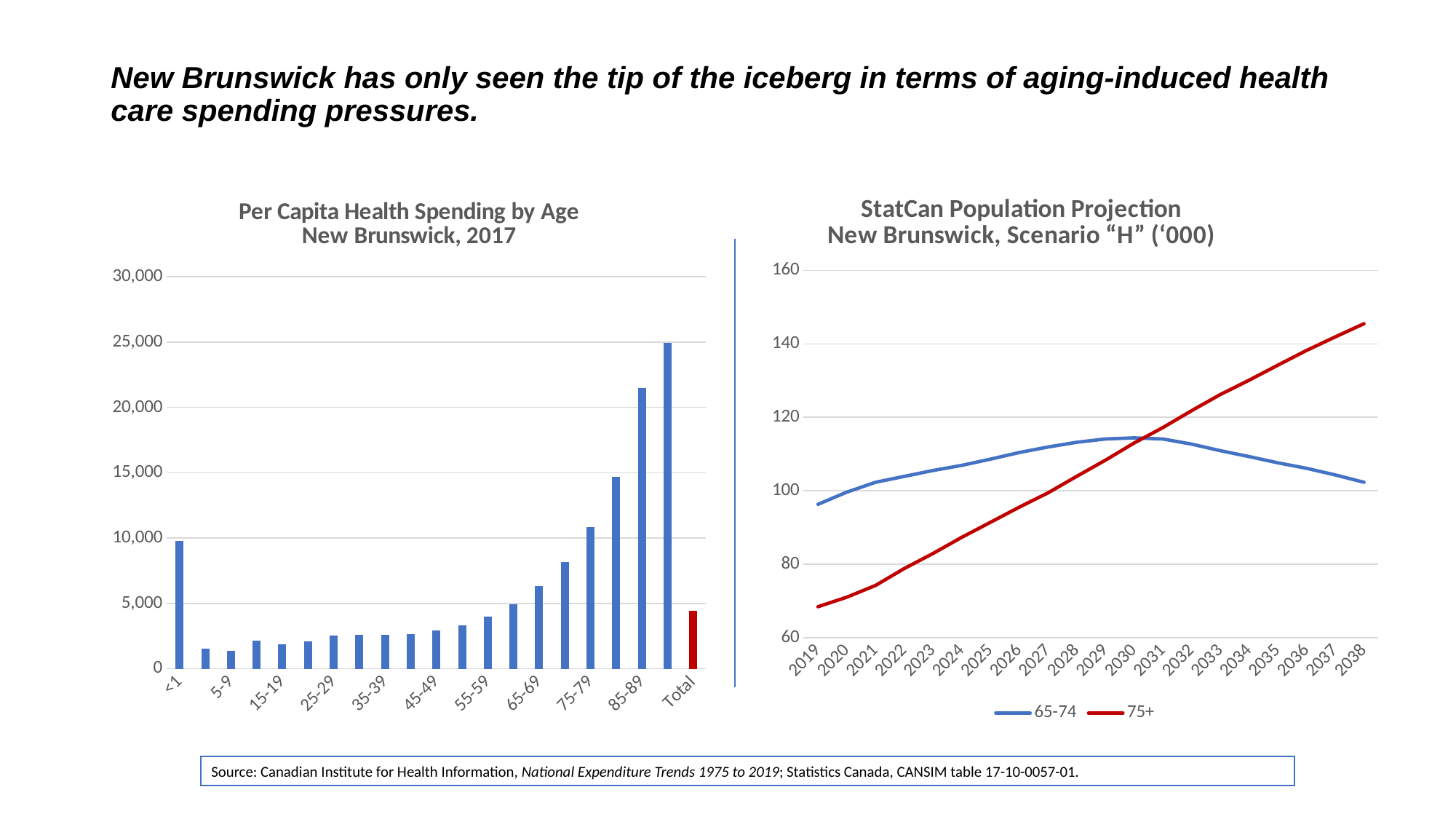
In the 'Per Capita Health Spending by Age' chart, is the value for Total greater or less than 5,000? less In the 'Per Capita Health Spending by Age' chart, what colour is the Total bar? red In the 'StatCan Population Projection' chart, how many years are shown on the x axis? 20 In the 'StatCan Population Projection' chart, how many series does the legend list? 2 In the 'Per Capita Health Spending by Age' chart, is the value for 85-89 greater or less than 20,000? greater What type of chart is the 'Per Capita Health Spending by Age' chart on the left? bar chart In the 'StatCan Population Projection' chart, which series is larger in 2038, 65-74 or 75+? 75+ In the 'Per Capita Health Spending by Age' chart, do the values rise or fall from 5-9 through 85-89? rise What type of chart is the 'StatCan Population Projection' chart on the right? line chart In the 'StatCan Population Projection' chart, is the 75+ value for 2019 greater or less than 80? less In the 'Per Capita Health Spending by Age' chart, which is larger, the value for 85-89 or the value for 75-79? 85-89 In the 'StatCan Population Projection' chart, does the 75+ series rise or fall from 2019 to 2038? rise